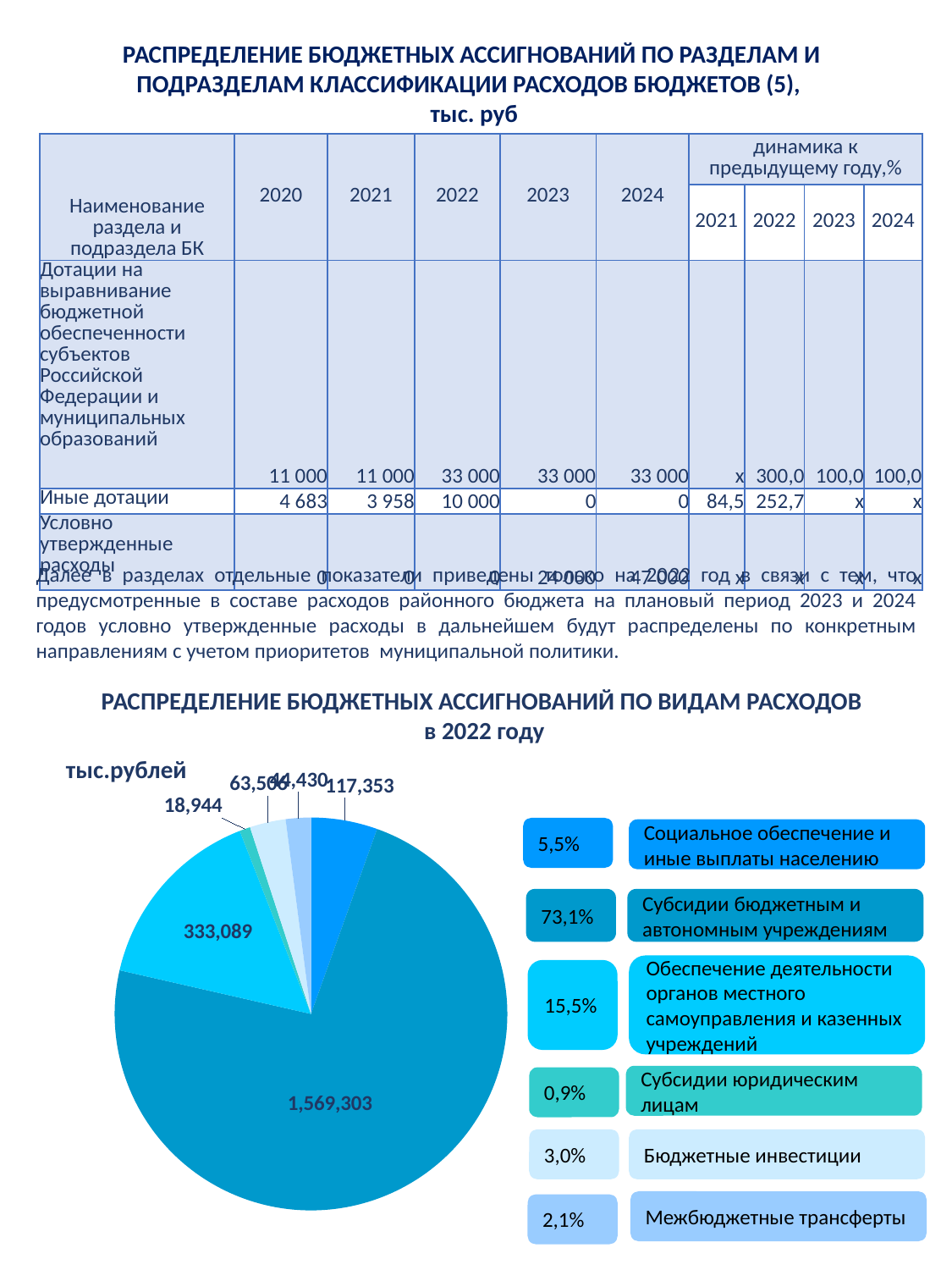
What share of the pie does "Межбюджетные трансферты" represent? 2,1% In the pie chart, what is the value for "Социальное обеспечение и иные выплаты населению"? 117,353 Which category has the smallest slice in the pie chart? Субсидии юридическим лицам What kind of chart is shown under the title "РАСПРЕДЕЛЕНИЕ БЮДЖЕТНЫХ АССИГНОВАНИЙ ПО ВИДАМ РАСХОДОВ в 2022 году"? pie chart What unit label is shown at the top left of the pie chart? тыс.рублей In the pie chart, what is the value for "Субсидии юридическим лицам"? 18,944 In the pie chart, what is the value for "Субсидии бюджетным и автономным учреждениям"? 1,569,303 How many slices does the pie chart have? 6 In the pie chart, what is the difference between the values for "Субсидии бюджетным и автономным учреждениям" and "Обеспечение деятельности органов местного самоуправления и казенных учреждений"? 1,236,214 In the pie chart, what is the value for "Обеспечение деятельности органов местного самоуправления и казенных учреждений"? 333,089 Which category has the largest slice in the pie chart? Субсидии бюджетным и автономным учреждениям What share of the pie does "Обеспечение деятельности органов местного самоуправления и казенных учреждений" represent? 15,5%